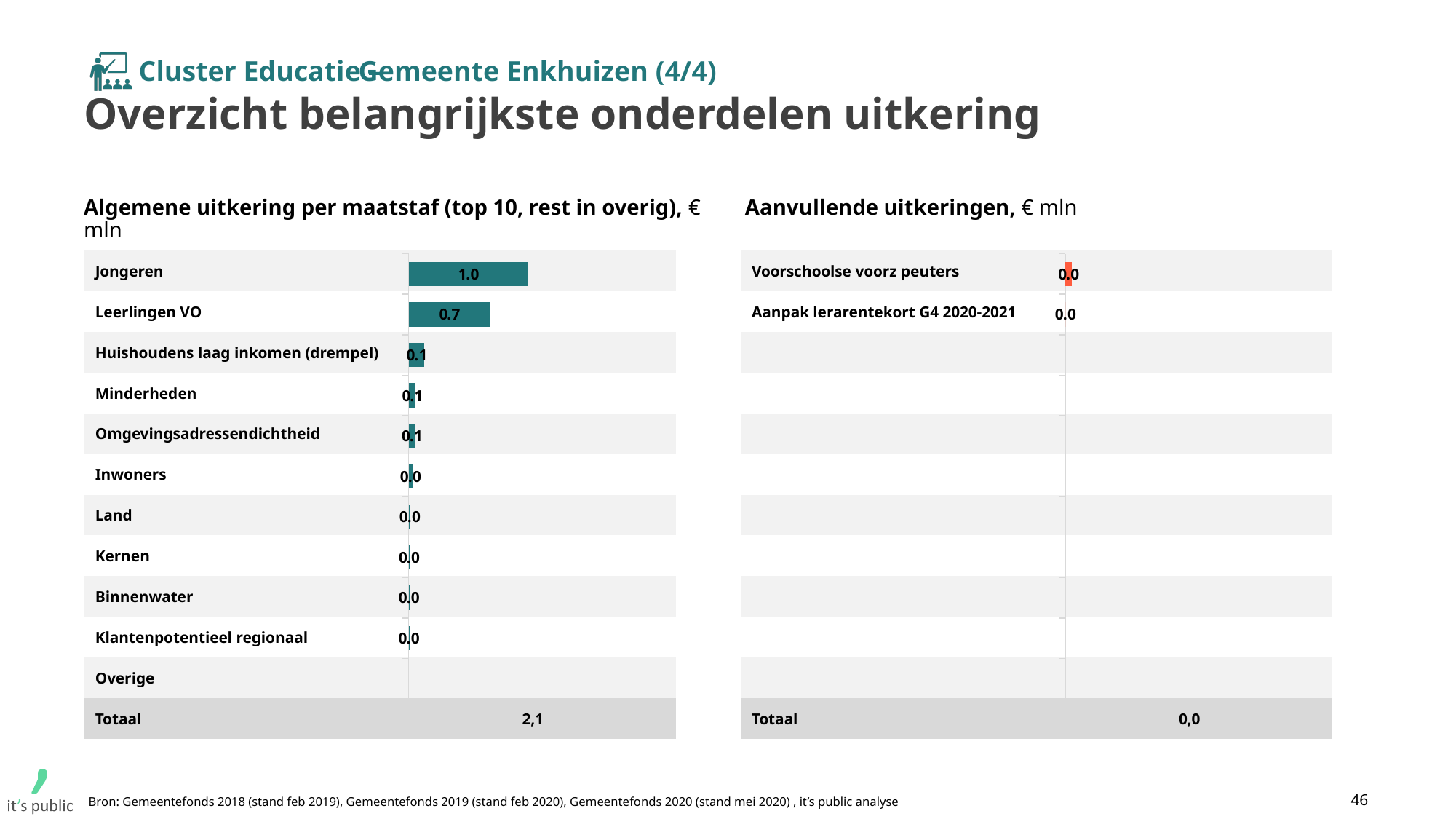
In the chart 'Aanvullende uitkeringen', what is the Totaal shown? 0,0 In the chart 'Algemene uitkering per maatstaf', what is the Totaal shown? 2,1 In the chart 'Algemene uitkering per maatstaf', what is the value for Inwoners? 0.0 In the chart 'Algemene uitkering per maatstaf', what is the difference between the values for Jongeren and Leerlingen VO? 0.3 What kind of chart is 'Algemene uitkering per maatstaf'? Bar chart In the chart 'Algemene uitkering per maatstaf', what is the value for Leerlingen VO? 0.7 In the chart 'Algemene uitkering per maatstaf', which category has the highest value? Jongeren In the chart 'Algemene uitkering per maatstaf', which is larger: Leerlingen VO or Minderheden? Leerlingen VO In the chart 'Aanvullende uitkeringen', what is the value for Voorschoolse voorz peuters? 0.0 In the chart 'Aanvullende uitkeringen', how many named categories are plotted? 2 In the chart 'Algemene uitkering per maatstaf', what is the value for Jongeren? 1.0 In the chart 'Algemene uitkering per maatstaf', what is the value for Huishoudens laag inkomen (drempel)? 0.1